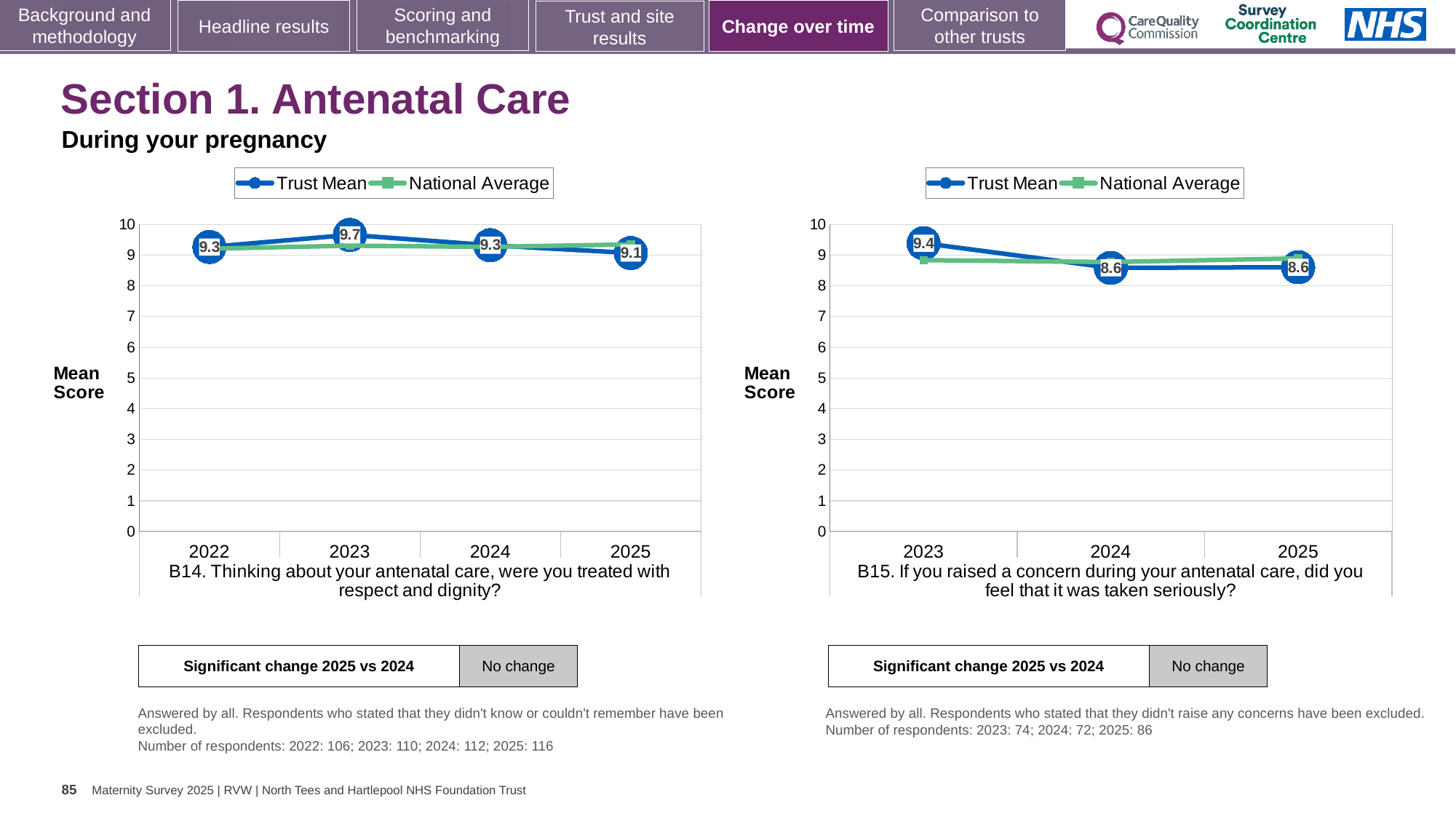
In the B14 chart (left), what is the Trust Mean for 2025? 9.1 In the B15 chart (right), is the National Average for 2025 greater or less than 8? greater In the B15 chart (right), what is the Trust Mean for 2023? 9.4 How many series does the legend of the B14 chart (left) list? 2 In the B14 chart (left), which year has the lowest Trust Mean? 2025 In the B14 chart (left), which year has the highest Trust Mean? 2023 In the B15 chart (right), what is the difference between the Trust Mean for 2023 and 2024? 0.8 In the B15 chart (right), does the Trust Mean rise or fall from 2023 to 2024? Fall In the B14 chart (left), is the Trust Mean higher in 2023 or in 2025? 2023 What kind of chart is the B14 chart (left)? Line chart In the B14 chart (left), what is the Trust Mean for 2023? 9.7 How many years are shown on the x axis of the B15 chart (right)? 3